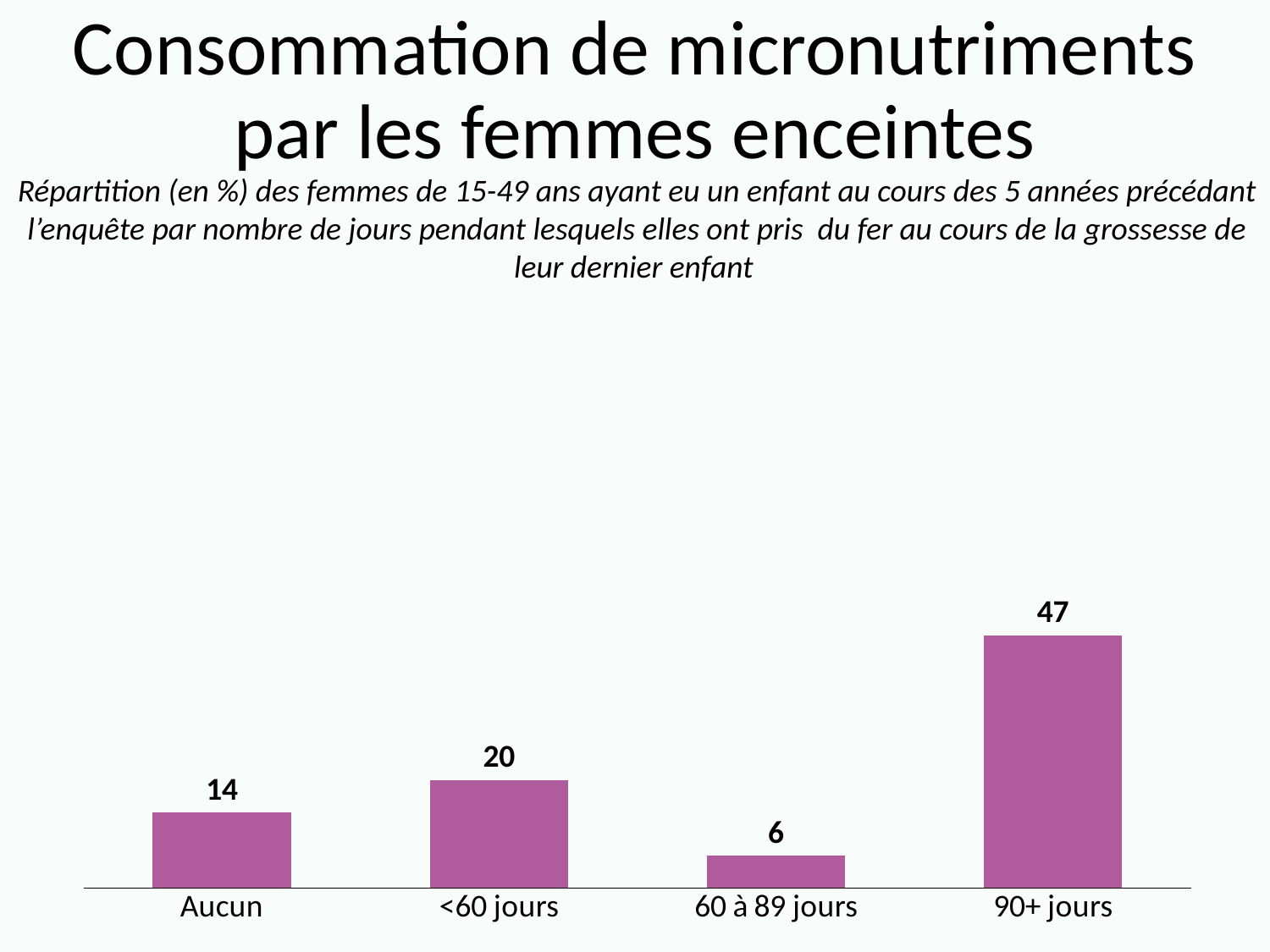
Which category has the lowest value? 60 à 89 jours What is the value for the "<60 jours" category? 20 What kind of chart is shown on the slide? Bar chart Which category has the highest value? 90+ jours What is the difference between the values for "Aucun" and "60 à 89 jours"? 8 What is the value for the "60 à 89 jours" category? 6 What colour are the bars in the chart? Purple What is the value for the "90+ jours" category? 47 Which is larger, the value for "Aucun" or the value for "<60 jours"? <60 jours How many categories are shown on the x axis? 4 What is the difference between the values for "90+ jours" and "<60 jours"? 27 What is the value for the "Aucun" category? 14